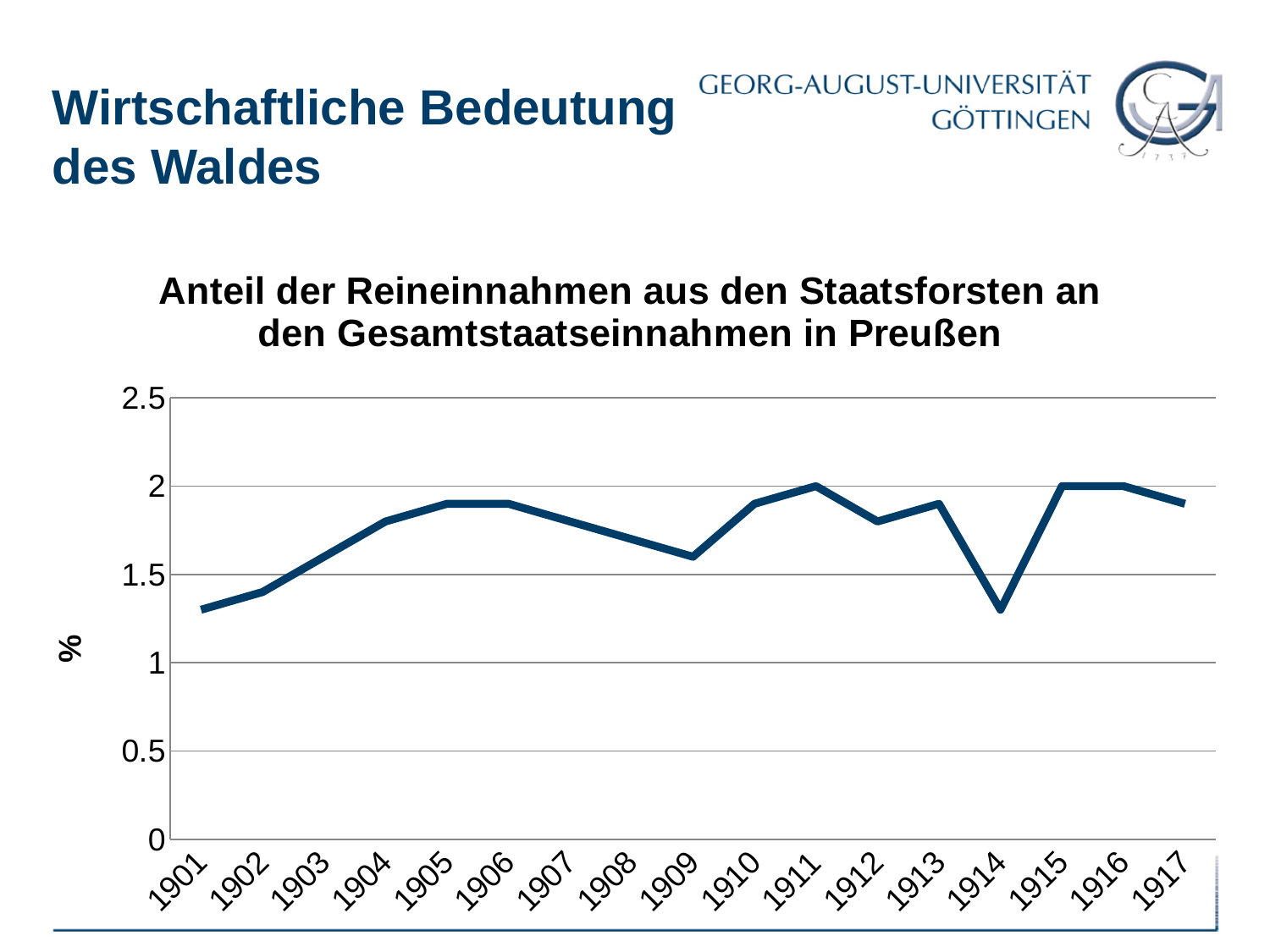
What kind of chart is shown on the slide? line chart What label is shown on the y axis of the chart? % What is the title of the chart? Anteil der Reineinnahmen aus den Staatsforsten an den Gesamtstaatseinnahmen in Preußen Is the value for 1905 greater or less than 1.5? greater Is the value for 1914 greater or less than 1.5? less How many years are plotted along the x axis of the chart? 17 Do the values rise or fall from 1901 to 1905? rise Is the value for 1912 greater or less than 1.5? greater Which year has the larger value, 1913 or 1914? 1913 Do the values rise or fall from 1913 to 1914? fall Which year has the larger value, 1901 or 1905? 1905